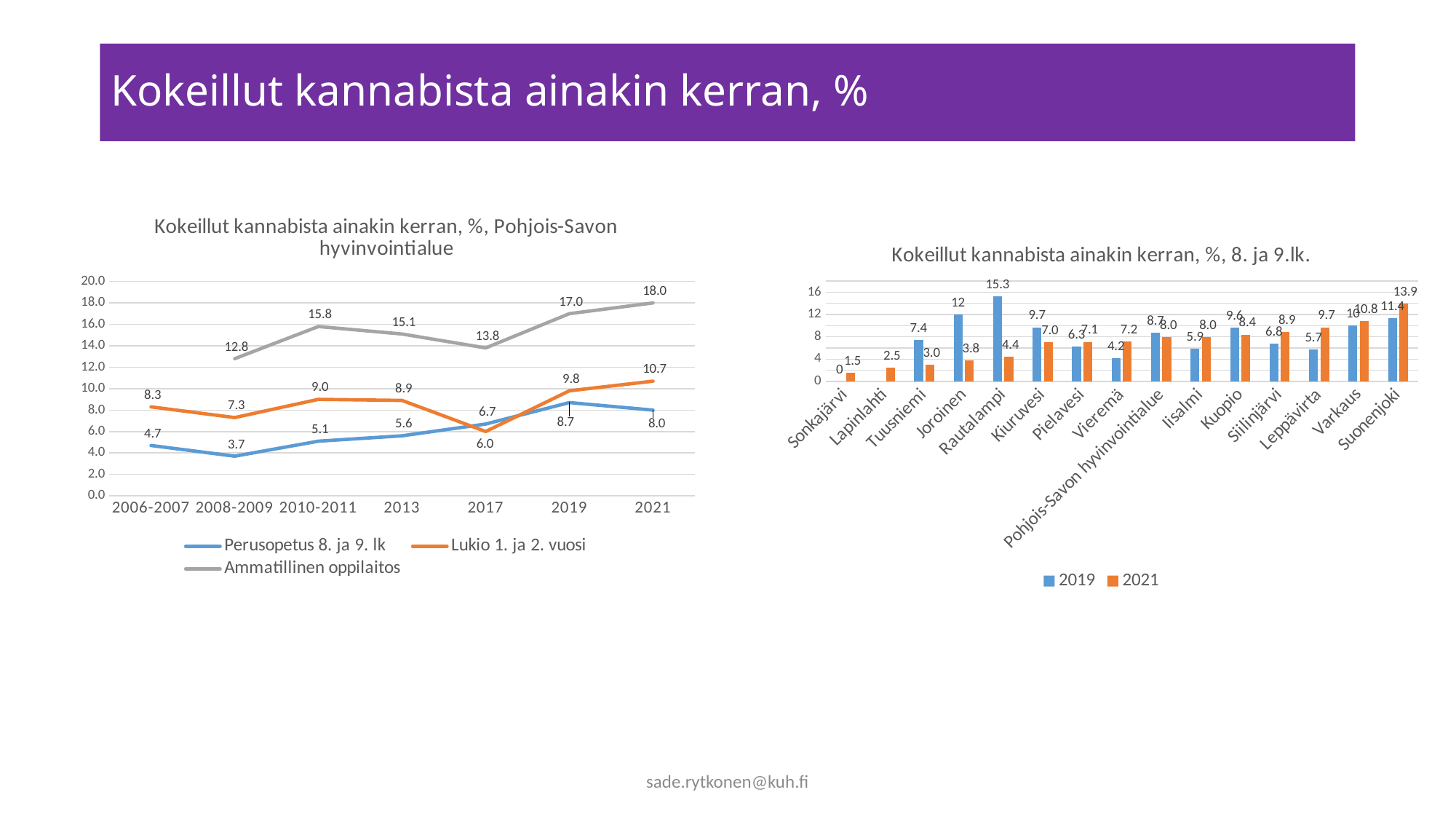
On the left chart (Pohjois-Savon hyvinvointialue), what is the difference between the Ammatillinen oppilaitos value and the Perusopetus 8. ja 9. lk value in 2019? 8.3 On the right chart (8. ja 9.lk), which is larger for Kuopio: the 2019 value or the 2021 value? 2019 On the right chart (8. ja 9.lk), which municipality has the highest 2021 value? Suonenjoki On the left chart (Pohjois-Savon hyvinvointialue), what is the value for Lukio 1. ja 2. vuosi in 2017? 6.0 On the right chart (8. ja 9.lk), what is the 2021 value for Leppävirta? 9.7 On the right chart (8. ja 9.lk), what is the difference between the 2019 and 2021 values for Rautalampi? 10.9 On the left chart (Pohjois-Savon hyvinvointialue), what kind of chart is it? Line chart On the right chart (8. ja 9.lk), which category has the highest 2019 value? Rautalampi On the left chart (Pohjois-Savon hyvinvointialue), what is the value for Perusopetus 8. ja 9. lk in 2008-2009? 3.7 On the left chart (Pohjois-Savon hyvinvointialue), how many series does the legend list? 3 On the left chart (Pohjois-Savon hyvinvointialue), what is the value for Ammatillinen oppilaitos in 2021? 18.0 On the right chart (8. ja 9.lk), how many categories are shown on the x axis? 15